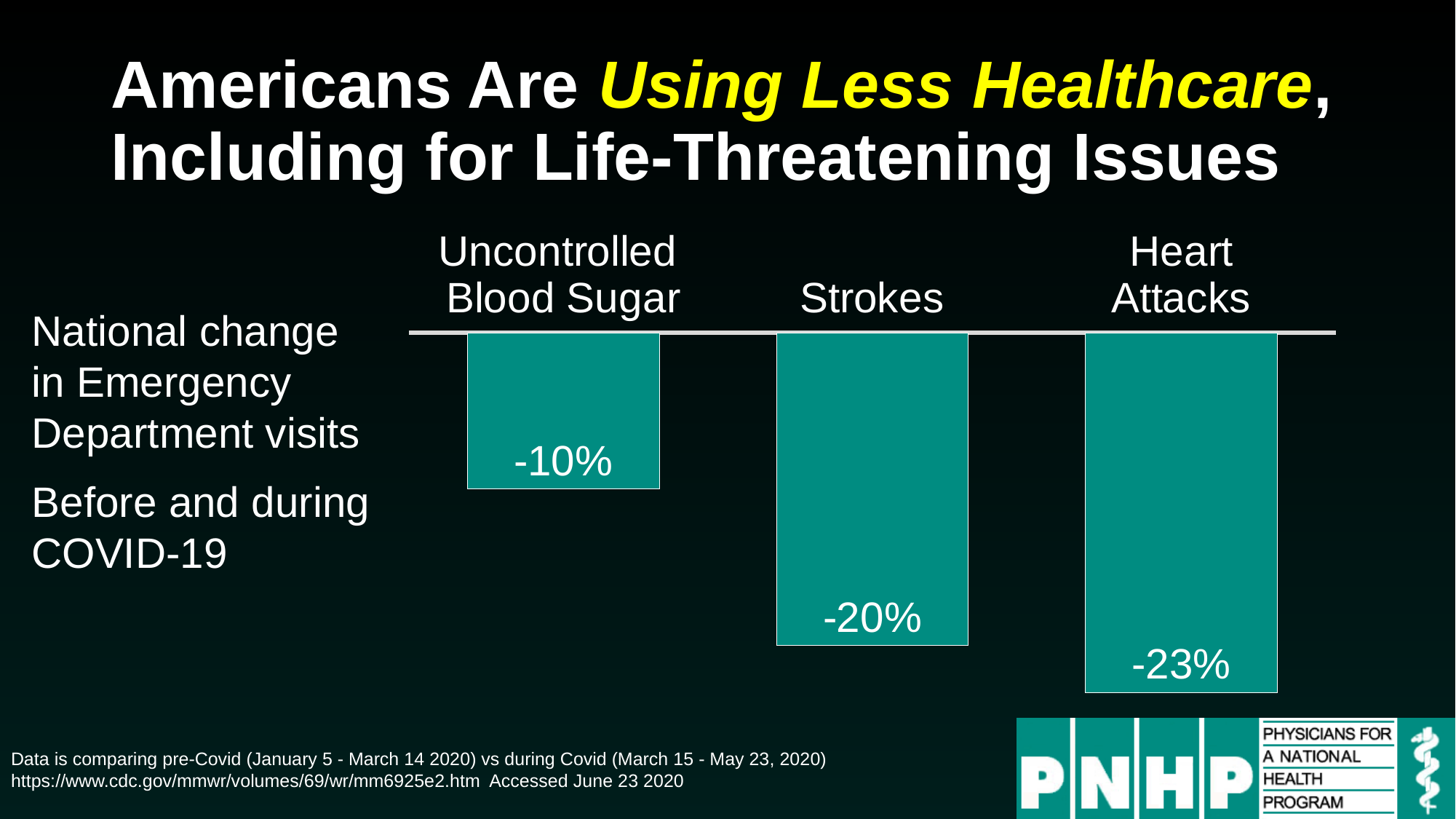
Do the values decrease or increase moving from left to right across the categories? Decrease What is the value shown for Strokes? -20% How many categories are shown in the chart? 3 Which category shows the largest decrease in Emergency Department visits? Heart Attacks What is the value shown for Heart Attacks? -23% What kind of chart is shown on the slide? Bar chart What colour are the bars in the chart? Teal What is the difference in percentage points between the values for Heart Attacks and Strokes? 3 percentage points Which shows a larger decrease, Strokes or Heart Attacks? Heart Attacks What is the value shown for Uncontrolled Blood Sugar? -10% What is the difference in percentage points between the values for Strokes and Uncontrolled Blood Sugar? 10 percentage points Which category shows the smallest decrease in Emergency Department visits? Uncontrolled Blood Sugar